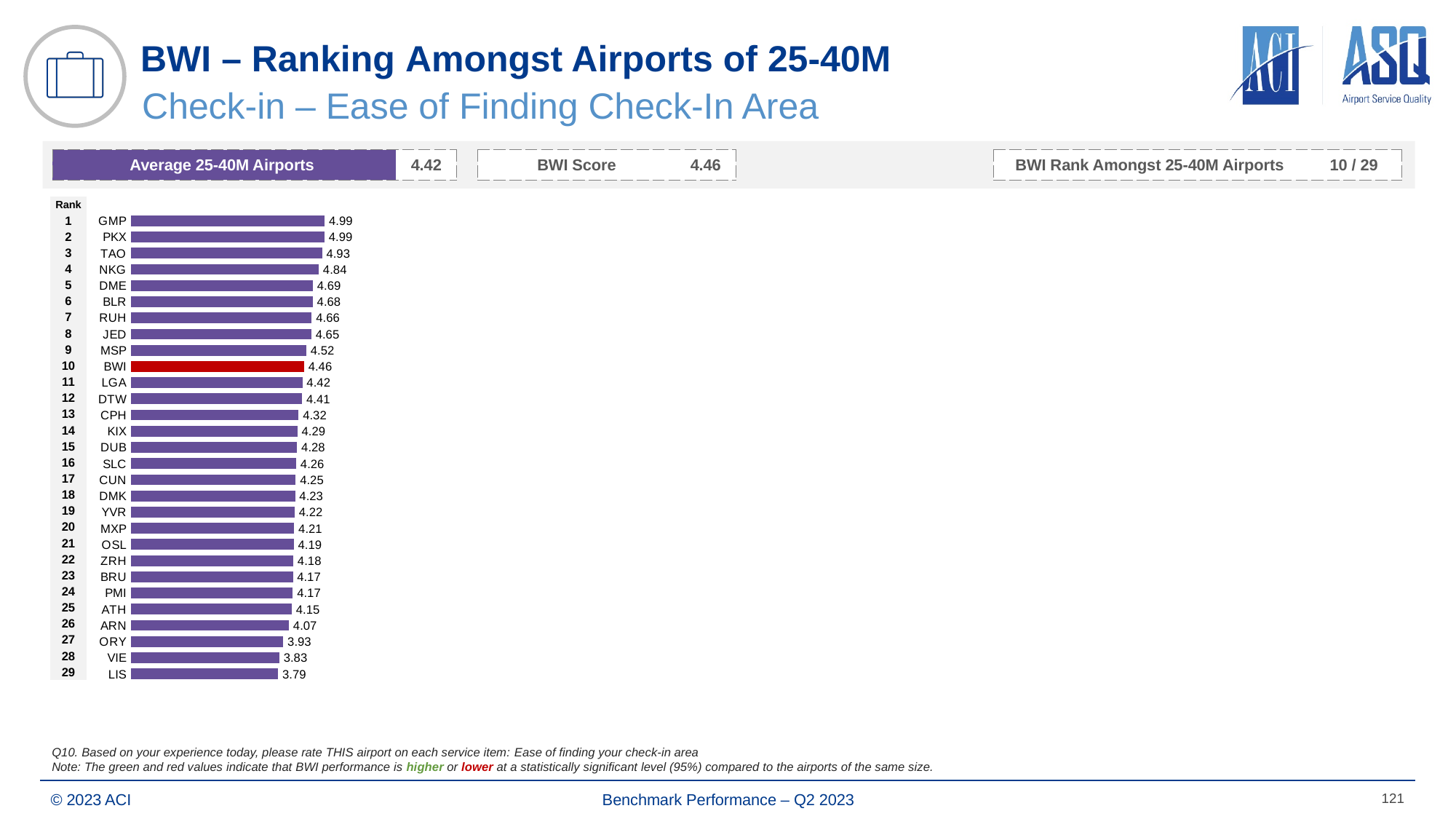
Which has a larger value, TAO or DME? TAO What kind of chart is shown? bar chart What is the value for BWI? 4.46 How many airports are shown in the chart? 29 What is the difference between the values for GMP and LIS? 1.20 What is the value for LIS? 3.79 Which airport has the lowest value? LIS What is the difference between the values for BWI and LGA? 0.04 What is the value for MSP? 4.52 Do the values rise or fall going down the ranking from rank 1 to rank 29? fall Which bar is coloured red in the chart? BWI Which has a larger value, ORY or ARN? ARN